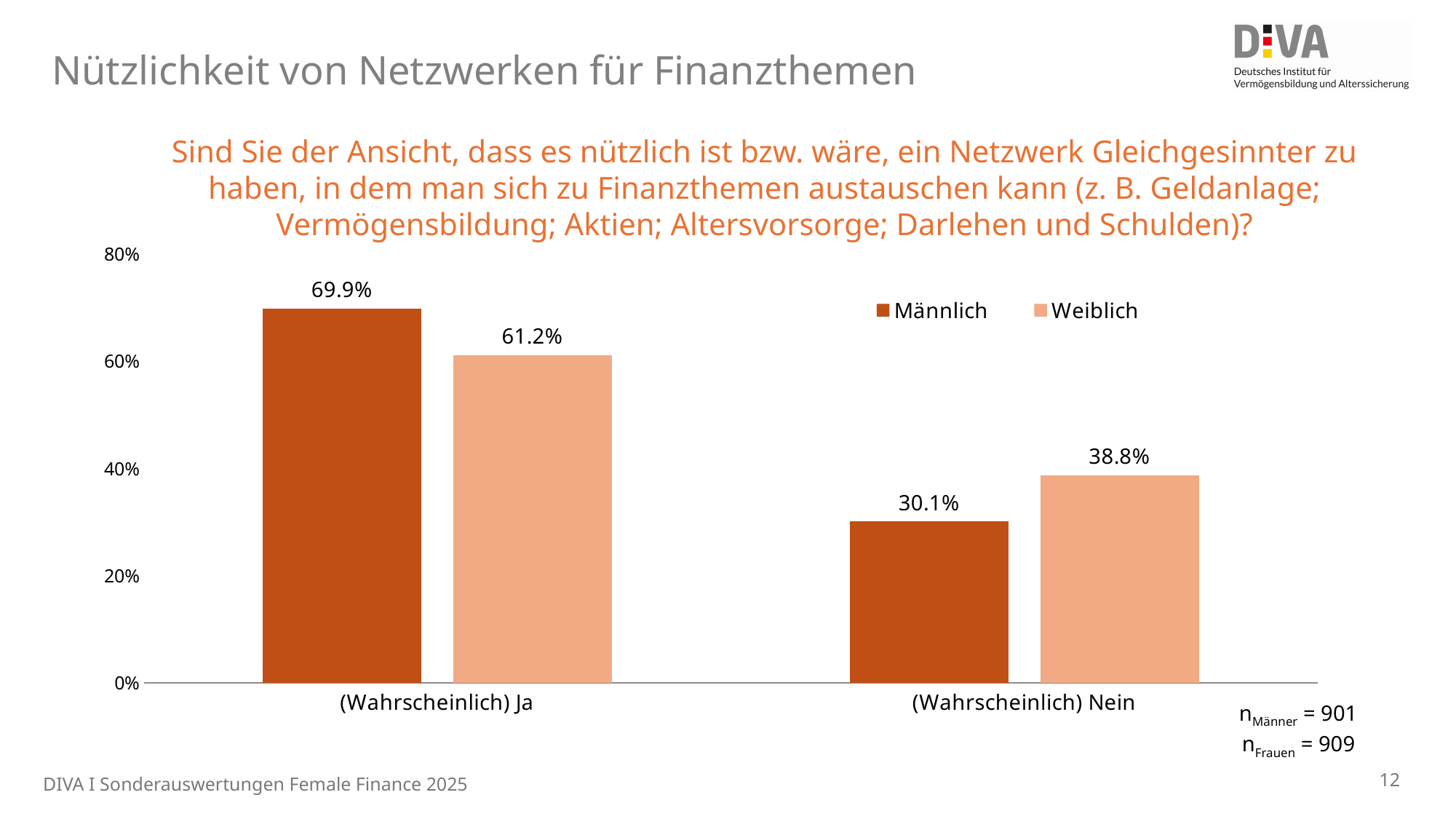
How many series does the legend list? 2 What kind of chart is shown on the slide? bar chart Which bar has the lowest value in the chart? Männlich, (Wahrscheinlich) Nein What is the difference between the Männlich and Weiblich values in the (Wahrscheinlich) Ja category? 8.7% Is the value for Weiblich in the (Wahrscheinlich) Nein category greater or less than 40%? less In the (Wahrscheinlich) Nein category, which series has the larger value, Männlich or Weiblich? Weiblich Which bar has the highest value in the chart? Männlich, (Wahrscheinlich) Ja What is the value for Weiblich in the (Wahrscheinlich) Ja category? 61.2% What is the value for Männlich in the (Wahrscheinlich) Ja category? 69.9% How many categories are shown on the x axis? 2 What is the value for Männlich in the (Wahrscheinlich) Nein category? 30.1% What is the value for Weiblich in the (Wahrscheinlich) Nein category? 38.8%